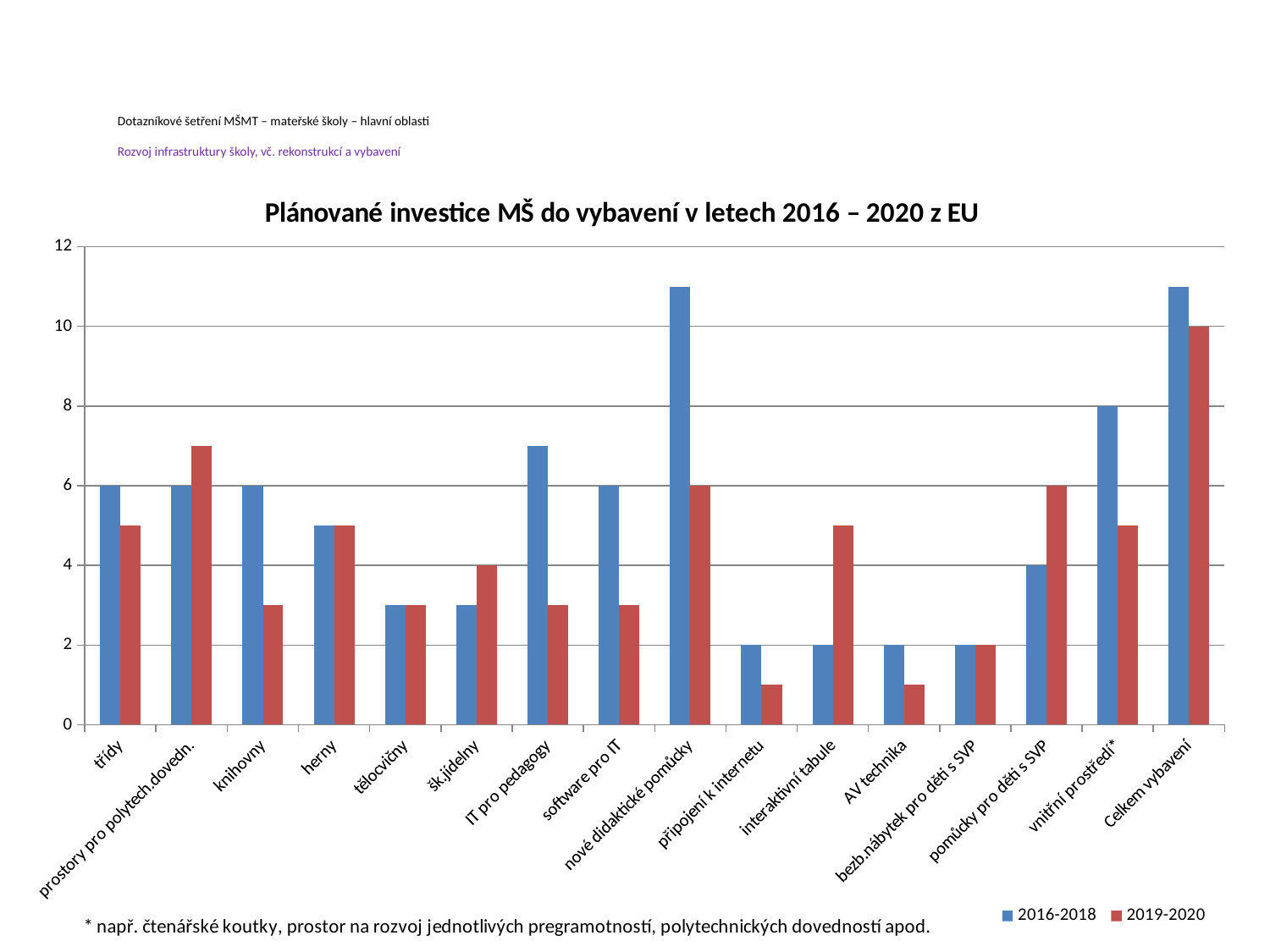
How many categories are shown on the x axis? 16 What type of chart is shown on the slide? bar chart What is the value for 'pomůcky pro děti s SVP' in the 2016-2018 series? 4 For 'interaktivní tabule', which series has the larger value, 2016-2018 or 2019-2020? 2019-2020 Is the value for 'nové didaktické pomůcky' in the 2016-2018 series greater or less than 10? greater Is the value for 'IT pro pedagogy' in the 2016-2018 series greater or less than 6? greater What is the value for 'Celkem vybavení' in the 2019-2020 series? 10 Which category has the highest value in the 2019-2020 series? Celkem vybavení How many series does the legend list? 2 What is the value for 'vnitřní prostředí*' in the 2016-2018 series? 8 What is the difference between the 2019-2020 value for 'Celkem vybavení' and the 2016-2018 value for 'vnitřní prostředí*'? 2 What is the value for 'třídy' in the 2016-2018 series? 6